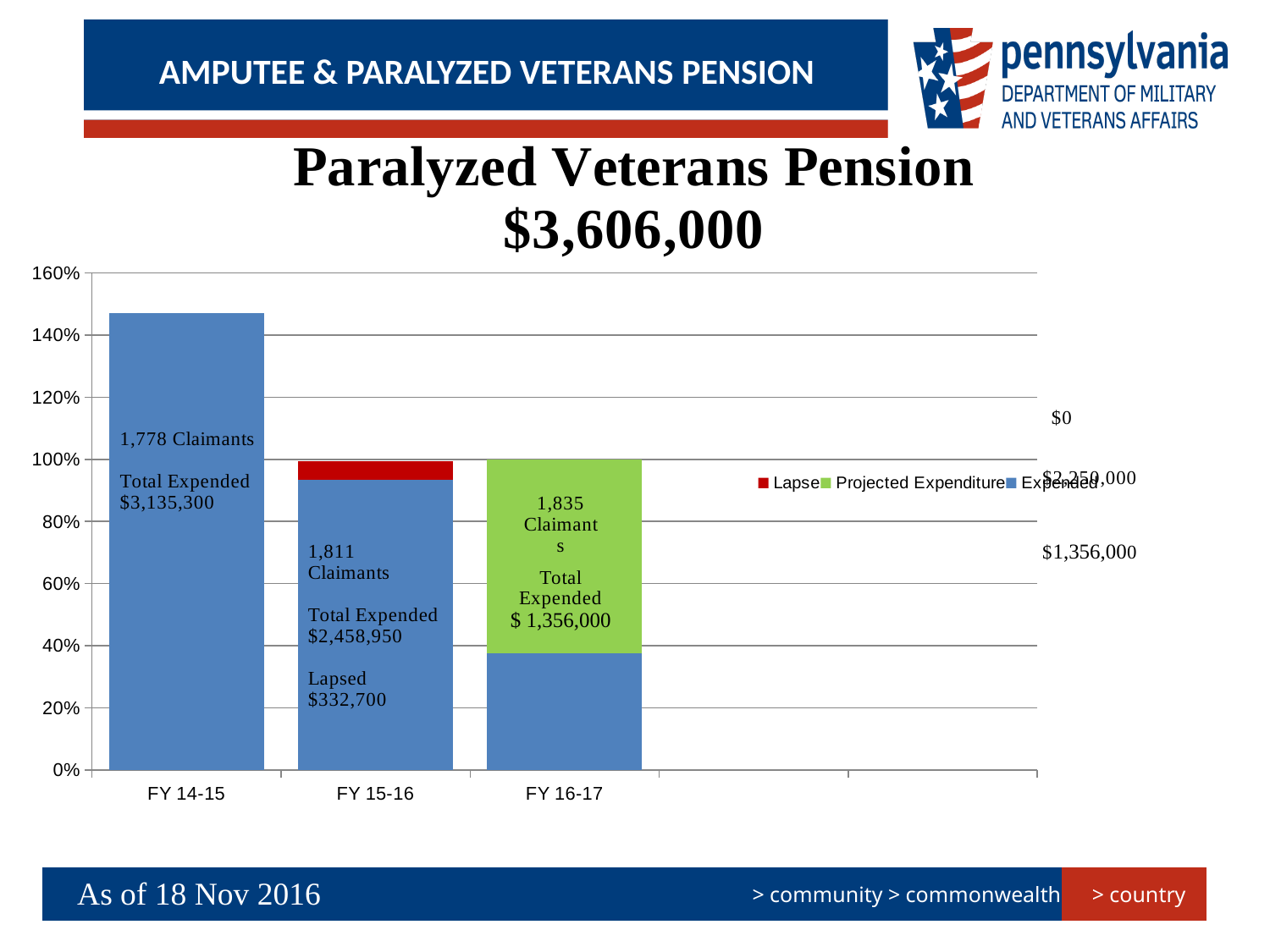
What kind of chart is shown on the slide? Stacked bar chart How many fiscal years are shown on the x axis of the chart? 3 How many series does the chart legend list? 3 What are the series names listed in the chart legend? Lapse, Projected Expenditure, Expended What is the Total Expended labelled for FY 15-16? $2,458,950 What is the Total Expended labelled for FY 14-15? $3,135,300 How many claimants are labelled for FY 14-15? 1,778 Claimants Which fiscal year has the tallest bar in the chart? FY 14-15 Is the top of the FY 14-15 bar greater or less than 140%? greater Which fiscal year is the only one with a Lapse segment in its bar? FY 15-16 What is the Lapsed amount labelled for FY 15-16? $332,700 How many claimants are labelled for FY 16-17? 1,835 Claimants